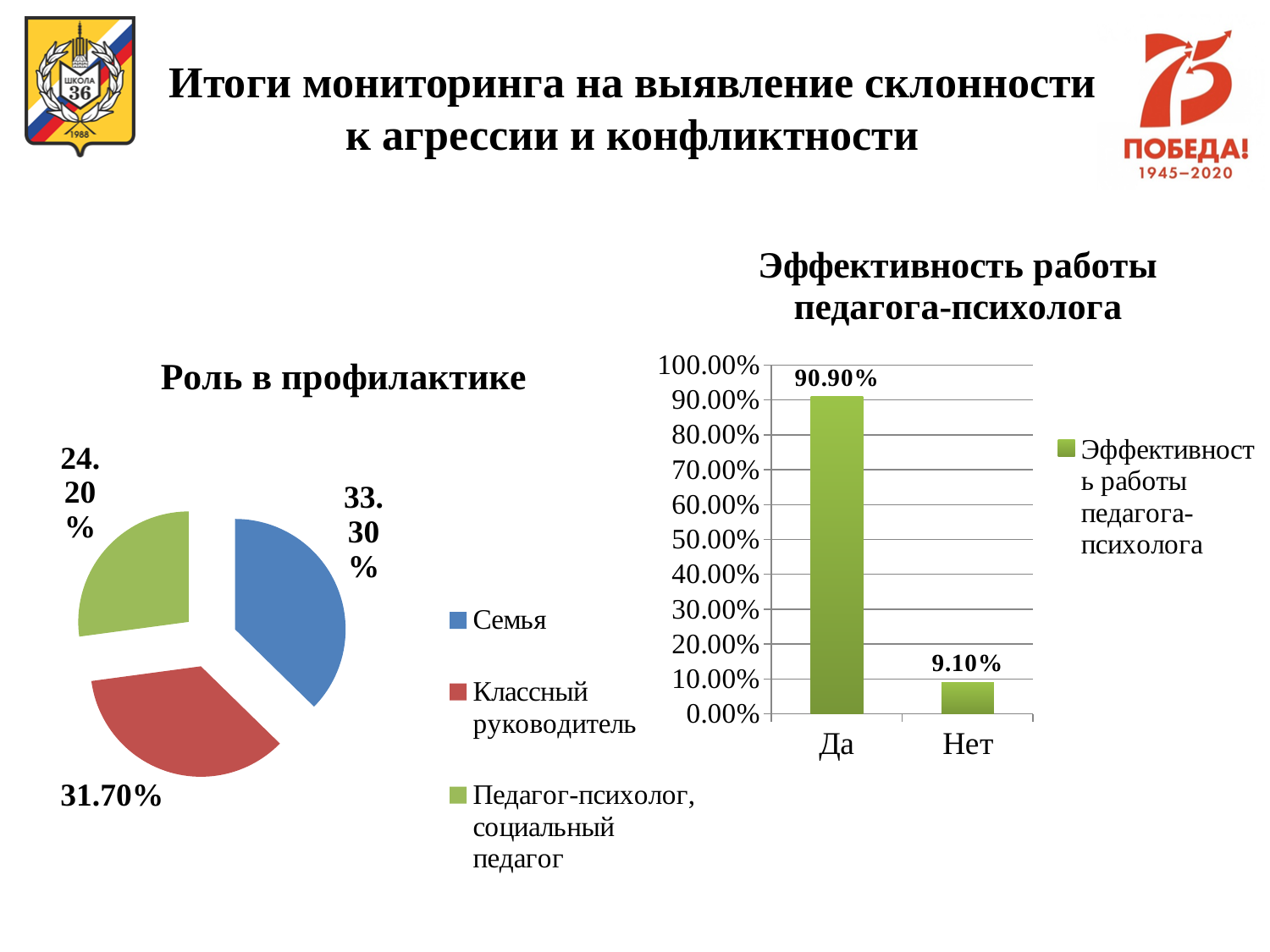
In the chart titled "Роль в профилактике", what kind of chart is shown? Pie chart In the chart titled "Эффективность работы педагога-психолога", what is the difference between the values for Да and Нет? 81.80% In the chart titled "Эффективность работы педагога-психолога", what is the value for Да? 90.90% In the chart titled "Роль в профилактике", how many categories does the legend list? 3 In the chart titled "Роль в профилактике", what is the value for Семья? 33.30% In the chart titled "Эффективность работы педагога-психолога", which category has the highest value? Да In the chart titled "Роль в профилактике", what is the value for Педагог-психолог, социальный педагог? 24.20% In the chart titled "Эффективность работы педагога-психолога", how many series does the legend list? 1 In the chart titled "Роль в профилактике", which category has the smallest share? Педагог-психолог, социальный педагог In the chart titled "Роль в профилактике", what is the value for Классный руководитель? 31.70% In the chart titled "Эффективность работы педагога-психолога", what is the value for Нет? 9.10% In the chart titled "Эффективность работы педагога-психолога", what kind of chart is shown? Bar chart